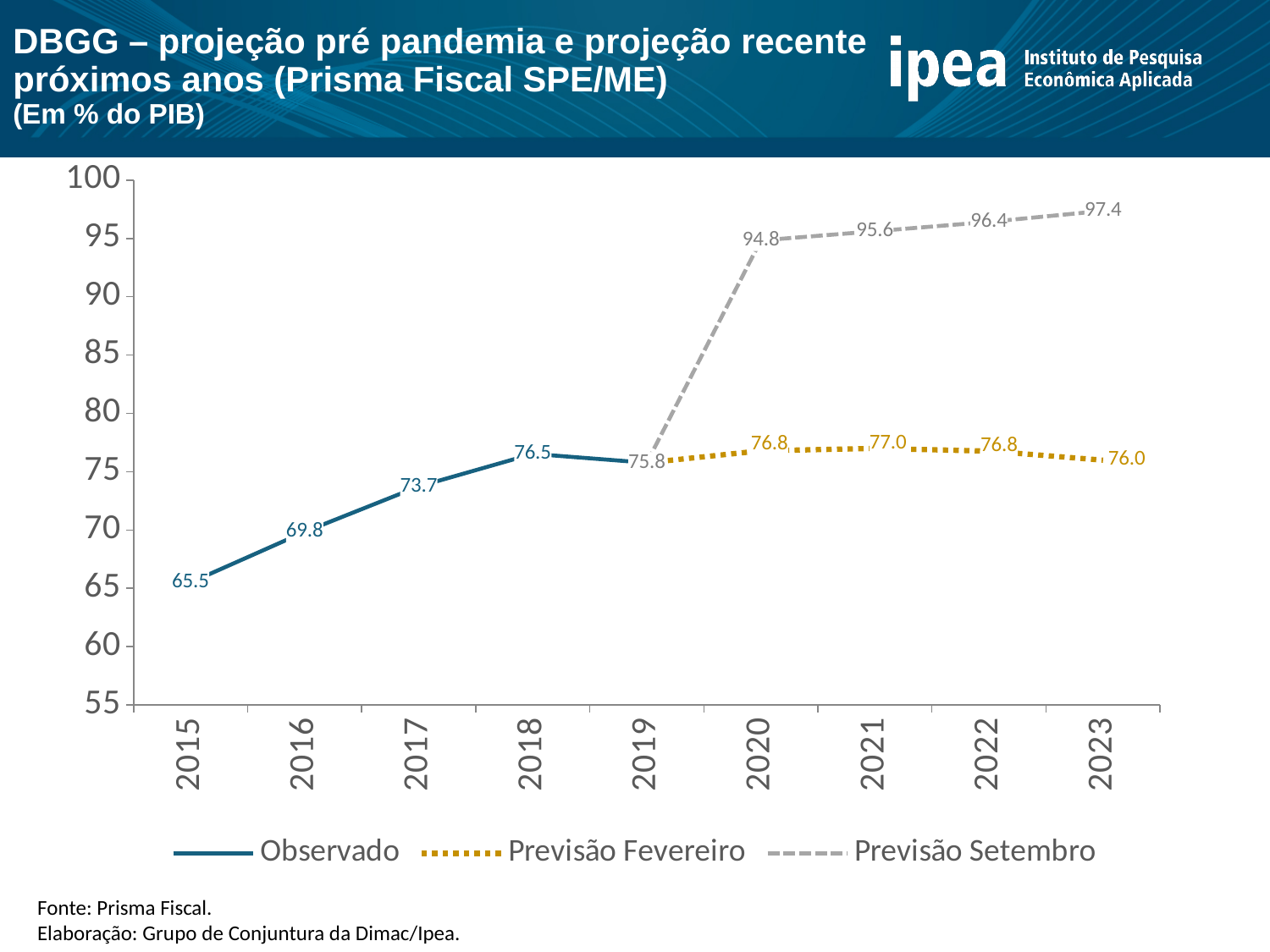
What is the Observado value for 2018? 76.5 How many series does the legend list? 3 What is the Previsão Fevereiro value for 2021? 77.0 Which year has the lowest Previsão Fevereiro value? 2019 What kind of chart is shown on the slide? line chart What is the difference between the Previsão Setembro and Previsão Fevereiro values for 2020? 18.0 What is the Observado value for 2015? 65.5 What is the Previsão Setembro value for 2023? 97.4 Which is larger in 2022, the Previsão Setembro value or the Previsão Fevereiro value? Previsão Setembro Do the Previsão Setembro values rise or fall from 2020 to 2023? rise Which year has the highest Observado value? 2018 How many years are shown on the x axis? 9